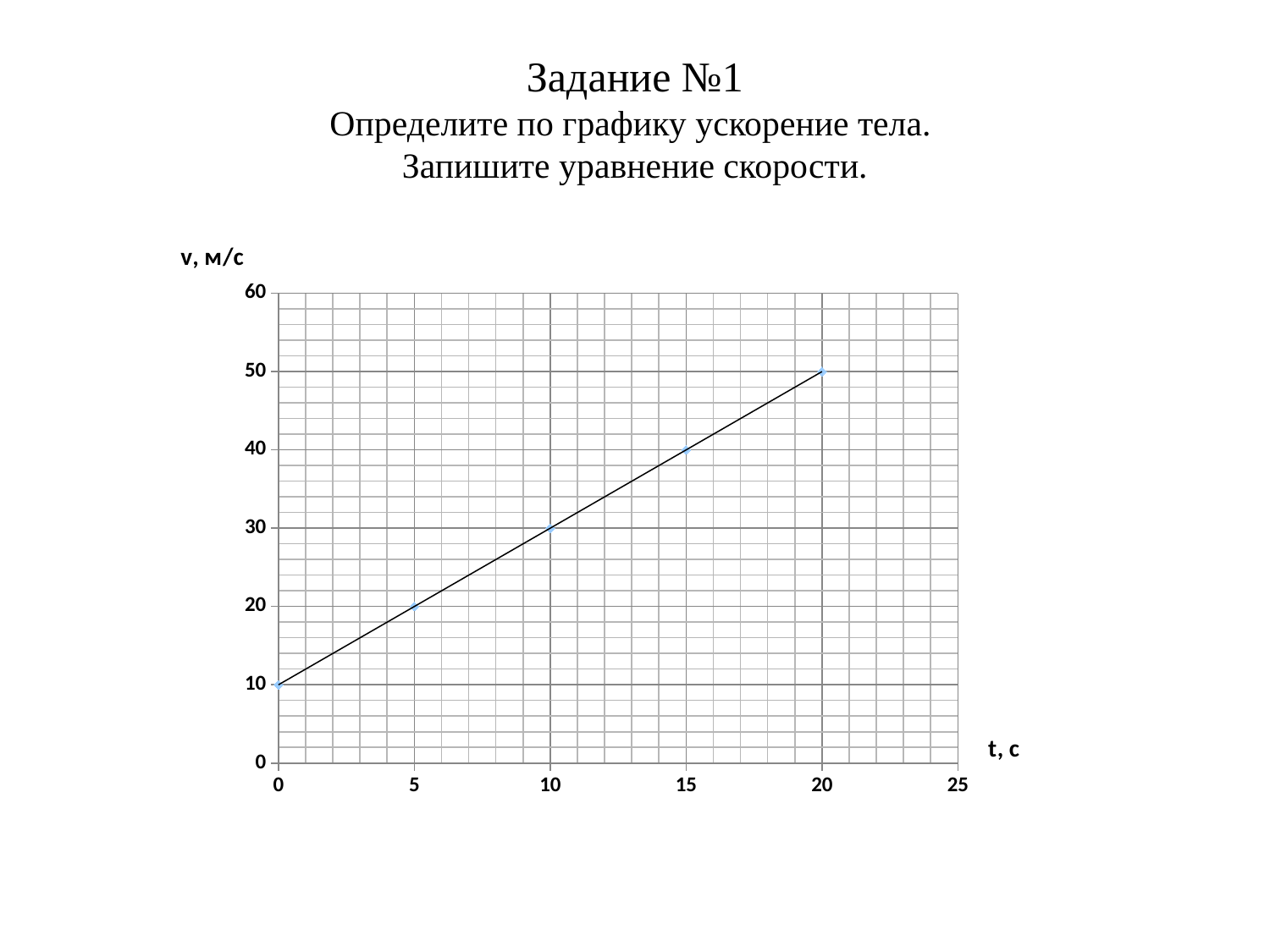
At which value of t is v highest? 20 What is the label of the vertical axis? v, м/с At which value of t is v lowest? 0 What is the value of v at t = 0 s? 10 What is the value of v at t = 10 s? 30 What is the value of v at t = 20 s? 50 What kind of chart is shown on the slide? line chart By how much does v increase from t = 0 s to t = 20 s? 40 How many data points are plotted on the chart? 5 What is the value of v at t = 5 s? 20 Does v rise or fall as t increases? rise Which is larger: v at t = 15 s or v at t = 5 s? v at t = 15 s